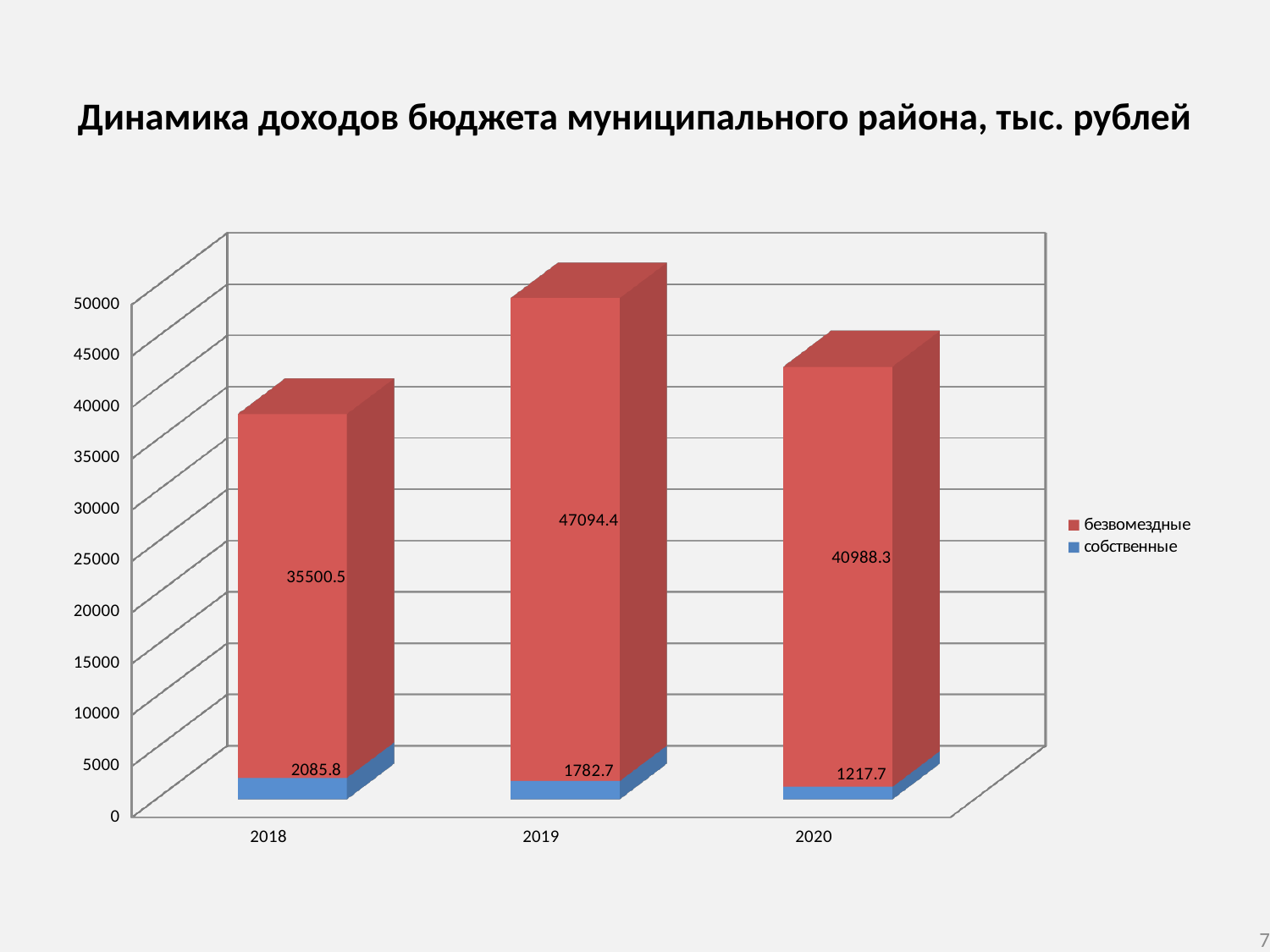
How many series does the legend list? 2 Which year has the lowest value of собственные? 2020 What is the value of безвозмездные for 2019? 47094.4 What kind of chart is shown on the slide? Stacked bar chart How many years are shown on the x axis? 3 Which year has the highest value of безвозмездные? 2019 What is the value of собственные for 2018? 2085.8 What is the total of the stacked bar for 2019? 48877.1 Which is larger: собственные in 2018 or собственные in 2020? 2018 Does the value of собственные rise or fall from 2018 to 2020? Fall What is the difference between the безвозмездные values for 2019 and 2018? 11593.9 What is the value of безвозмездные for 2020? 40988.3